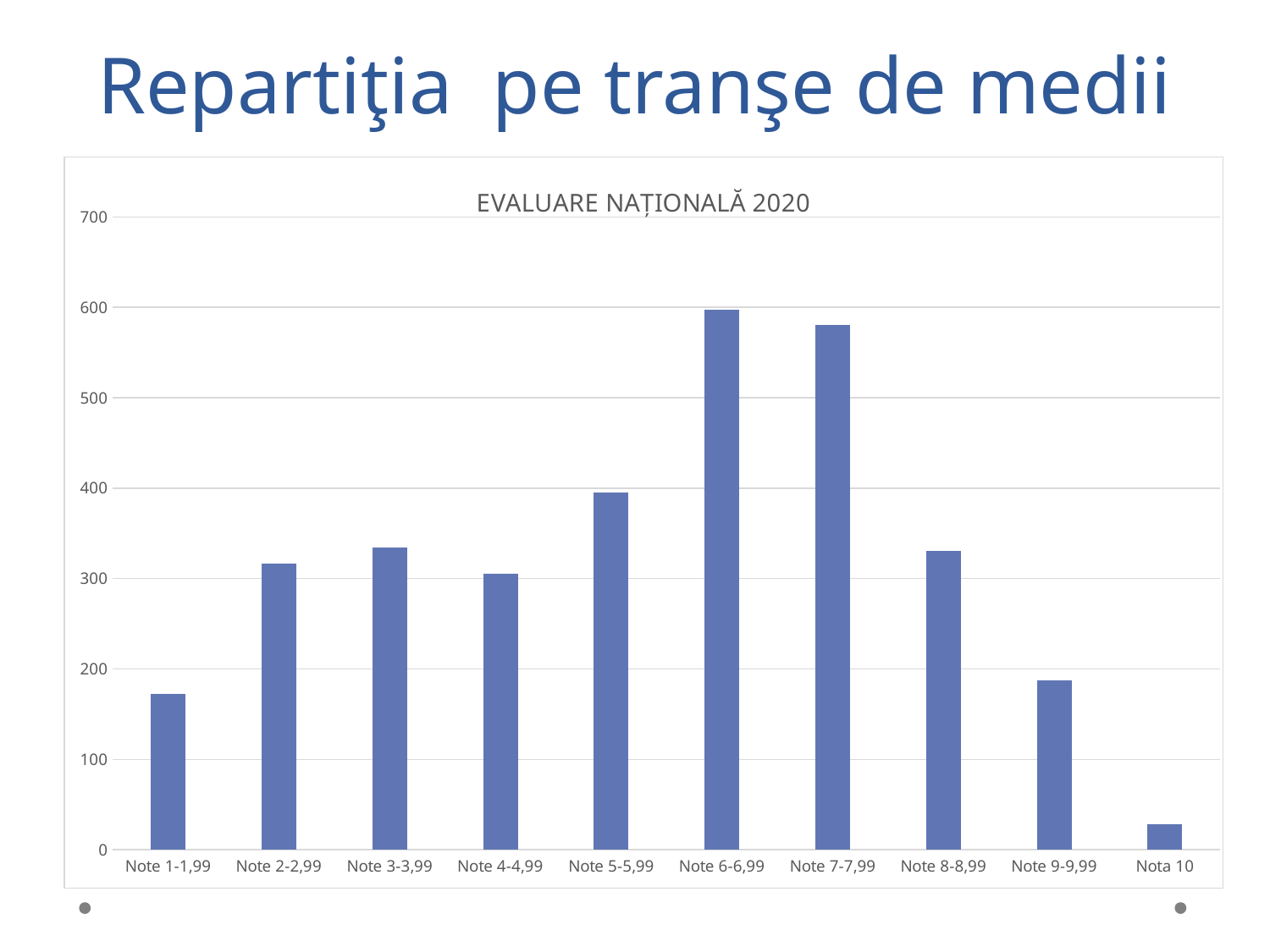
Is the value for Nota 10 greater or less than 100? less Which grade band has the highest bar? Note 6-6,99 Which grade band has the lowest bar? Nota 10 How many grade bands (categories) are shown on the x axis? 10 Which is larger, the value for Note 5-5,99 or the value for Note 4-4,99? Note 5-5,99 What is the title shown inside the chart? EVALUARE NAȚIONALĂ 2020 Which is larger, the value for Note 9-9,99 or the value for Note 8-8,99? Note 8-8,99 From Note 7-7,99 to Nota 10, do the values rise or fall along the x axis? fall Is the value for Note 7-7,99 greater or less than 500? greater Is the value for Note 8-8,99 greater or less than 300? greater What kind of chart is shown on the slide? bar chart